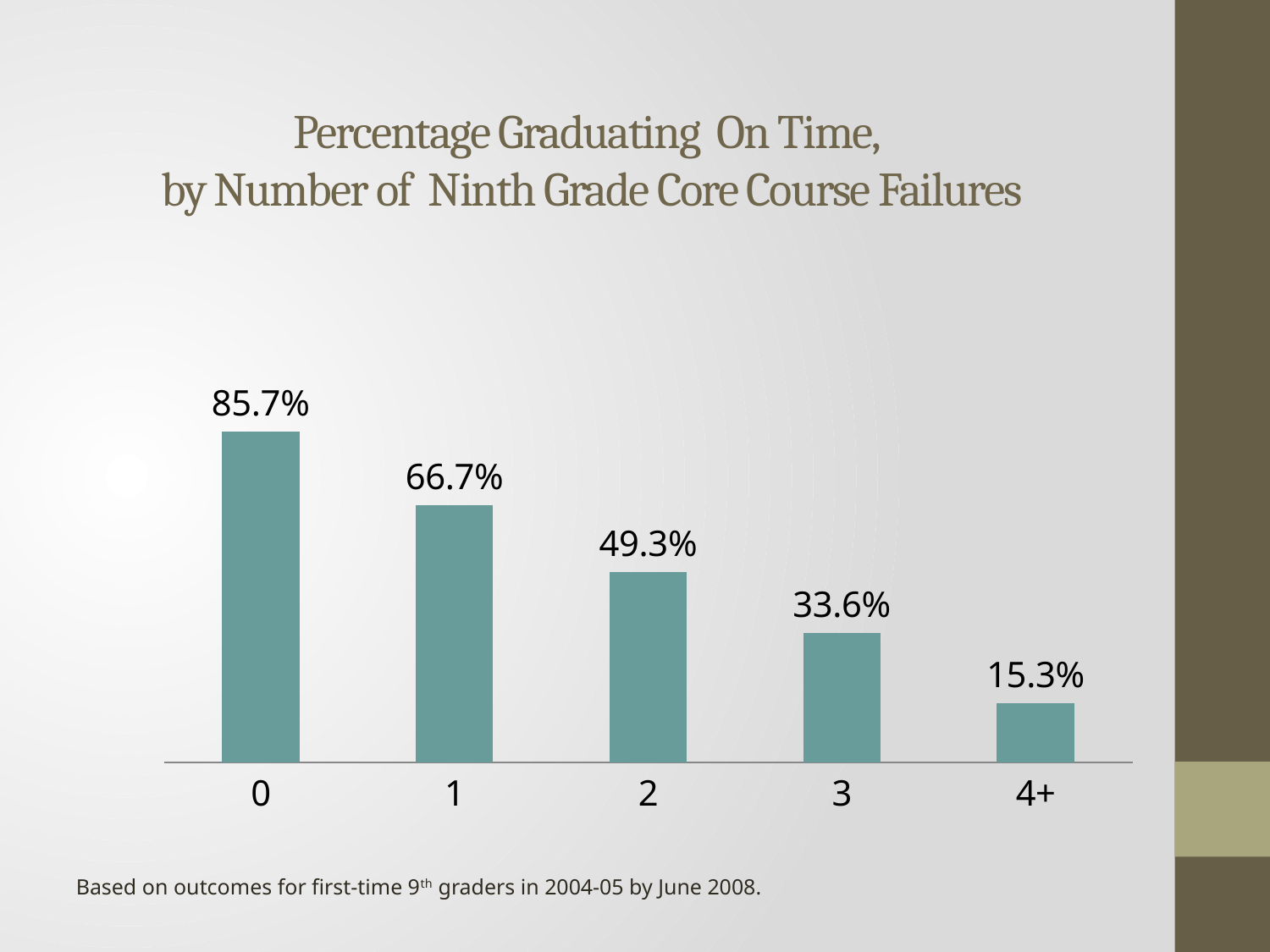
What is the difference in on-time graduation percentage between students with 0 failures and students with 1 failure? 19.0% How many categories are shown on the x axis? 5 What kind of chart is shown on the slide? Bar chart Do the values rise or fall as the number of core course failures increases? Fall What is the title of the chart? Percentage Graduating On Time, by Number of Ninth Grade Core Course Failures Which number of core course failures has the highest on-time graduation percentage? 0 What is the difference between the values for 3 failures and 4+ failures? 18.3% Which is larger: the percentage for 1 failure or the percentage for 3 failures? 1 failure What is the on-time graduation percentage for students with 2 core course failures? 49.3% Which category has the lowest on-time graduation percentage? 4+ What is the value shown for the 4+ failures category? 15.3% What percentage of students with 0 ninth grade core course failures graduated on time? 85.7%